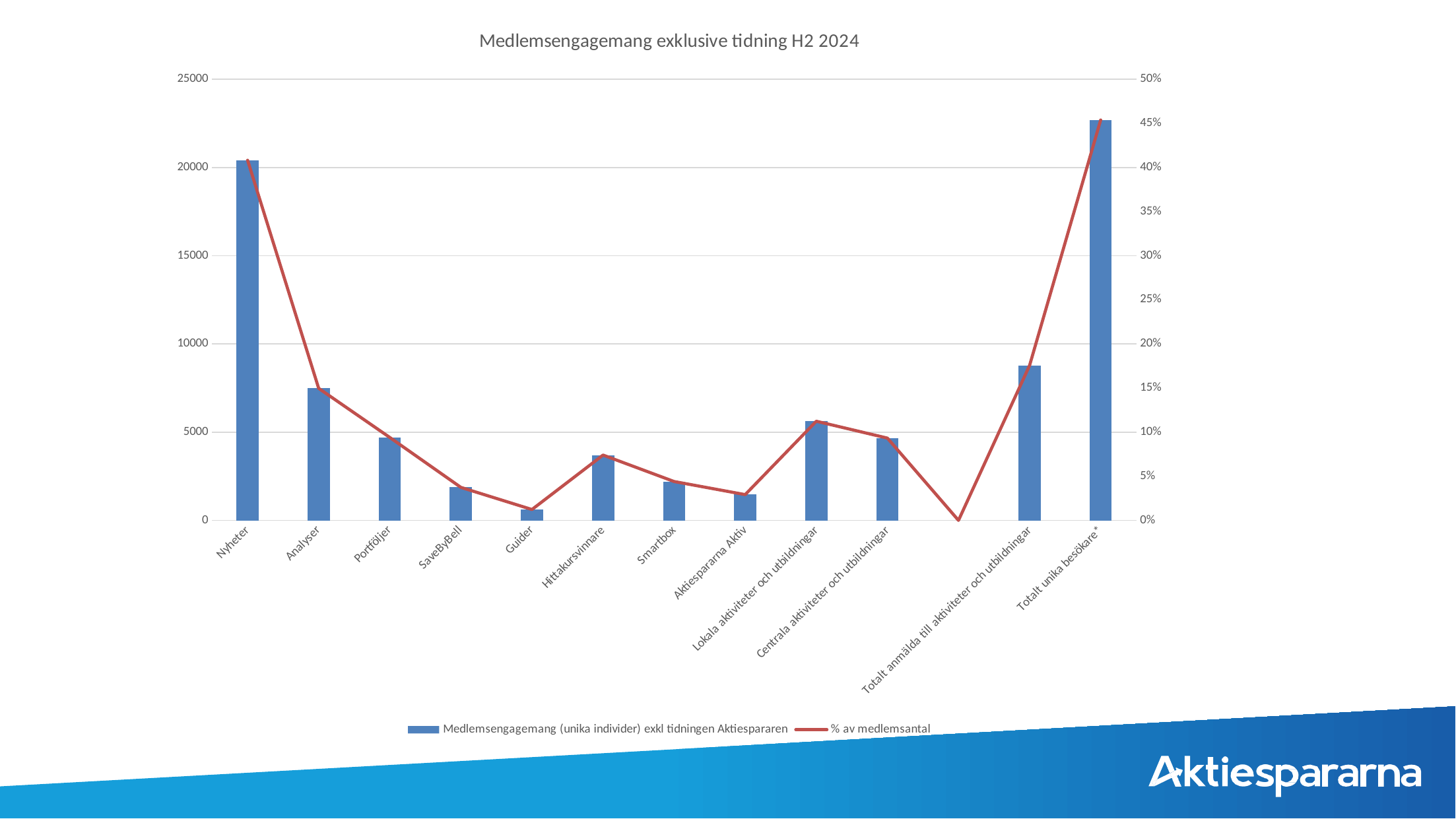
How many categories are shown on the x axis? 12 What kind of chart is this? Bar chart combined with a line chart Which category has the highest bar for Medlemsengagemang (unika individer)? Totalt unika besökare * Which category has the lowest bar for Medlemsengagemang (unika individer)? Guider Which has a larger Medlemsengagemang bar, Analyser or Portföljer? Analyser What colour is the line for % av medlemsantal? Red Is the Medlemsengagemang bar for Nyheter greater or less than 15000? greater How many series does the legend list? 2 What is the title of the chart? Medlemsengagemang exklusive tidning H2 2024 Is the Medlemsengagemang bar for Totalt unika besökare * greater or less than 20000? greater Is the Medlemsengagemang bar for Analyser greater or less than 5000? greater